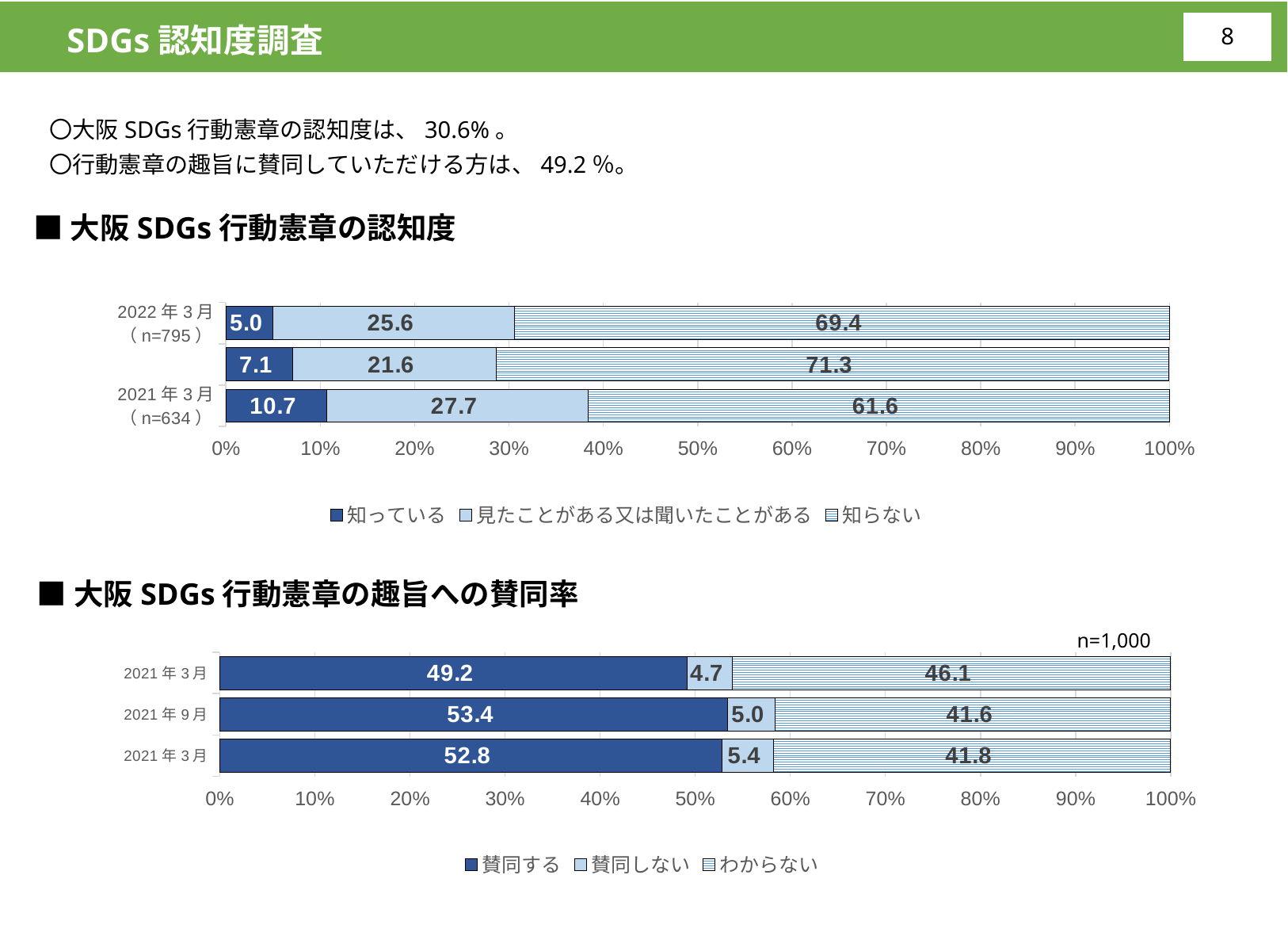
In the 大阪SDGs行動憲章の趣旨への賛同率 chart, what is the 賛同しない value in the top bar? 4.7 What kind of chart is the 大阪SDGs行動憲章の趣旨への賛同率 chart? stacked bar chart In the 大阪SDGs行動憲章の認知度 chart, what is the difference between the 知っている values for 2021年3月 (n=634) and 2022年3月 (n=795)? 5.7 In the 大阪SDGs行動憲章の趣旨への賛同率 chart, what is the value of わからない for 2021年9月? 41.6 In the 大阪SDGs行動憲章の認知度 chart, what is the value of 知らない for 2021年3月 (n=634)? 61.6 How many series does the legend of the 大阪SDGs行動憲章の認知度 chart list? 3 In the 大阪SDGs行動憲章の認知度 chart, which bar has the highest 知らない value: the top, middle, or bottom bar? middle bar In the 大阪SDGs行動憲章の趣旨への賛同率 chart, what is the value of 賛同する for 2021年9月? 53.4 In the 大阪SDGs行動憲章の趣旨への賛同率 chart, is the 賛同する value for 2021年9月 greater or less than 50%? greater In the 大阪SDGs行動憲章の認知度 chart, what is the value of 知っている for 2022年3月 (n=795)? 5.0 What sample size (n) is shown for the 大阪SDGs行動憲章の趣旨への賛同率 chart? n=1,000 In the 大阪SDGs行動憲章の認知度 chart, what is the value of 見たことがある又は聞いたことがある for 2022年3月 (n=795)? 25.6